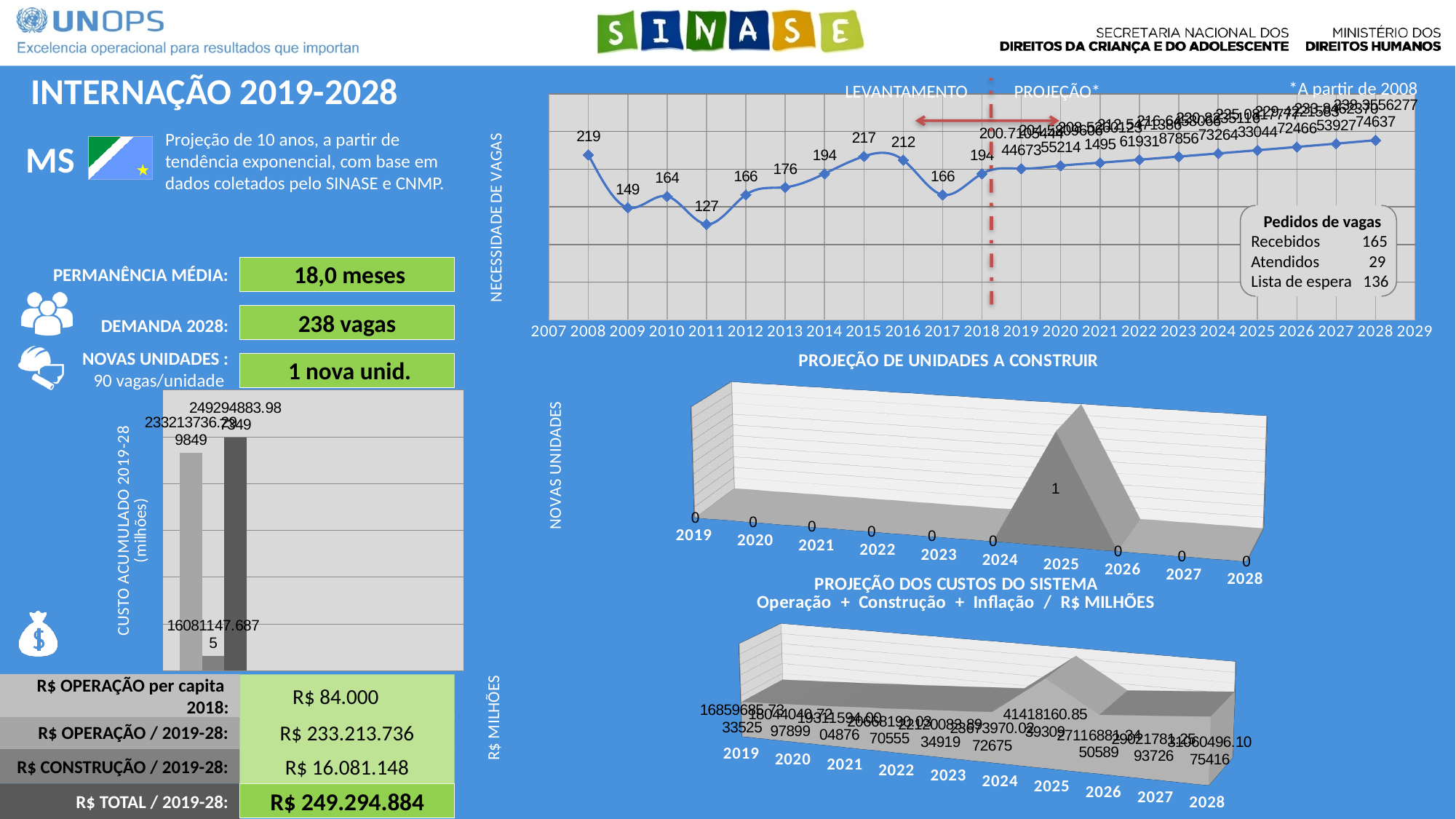
In the NECESSIDADE DE VAGAS line chart, do the projected values rise or fall from 2018 to 2028? rise How many bars are in the CUSTO ACUMULADO 2019-28 bar chart on the left of the slide? 3 In the NECESSIDADE DE VAGAS line chart, which year between 2008 and 2018 has the lowest value? 2011 In the PROJEÇÃO DE UNIDADES A CONSTRUIR chart, what is the value for 2025? 1 In the NECESSIDADE DE VAGAS line chart, what is the difference between the values for 2008 and 2011? 92 What kind of chart is the NECESSIDADE DE VAGAS chart at the top right? line chart In the PROJEÇÃO DE UNIDADES A CONSTRUIR chart, which year has the highest value? 2025 In the NECESSIDADE DE VAGAS line chart, what is the value for 2008? 219 In the NECESSIDADE DE VAGAS line chart, what is the value for 2015? 217 In the NECESSIDADE DE VAGAS line chart, which is larger, the value for 2014 or the value for 2016? 2016 In the NECESSIDADE DE VAGAS line chart, what is the value for 2011? 127 How many years are shown on the x axis of the PROJEÇÃO DE UNIDADES A CONSTRUIR chart? 10